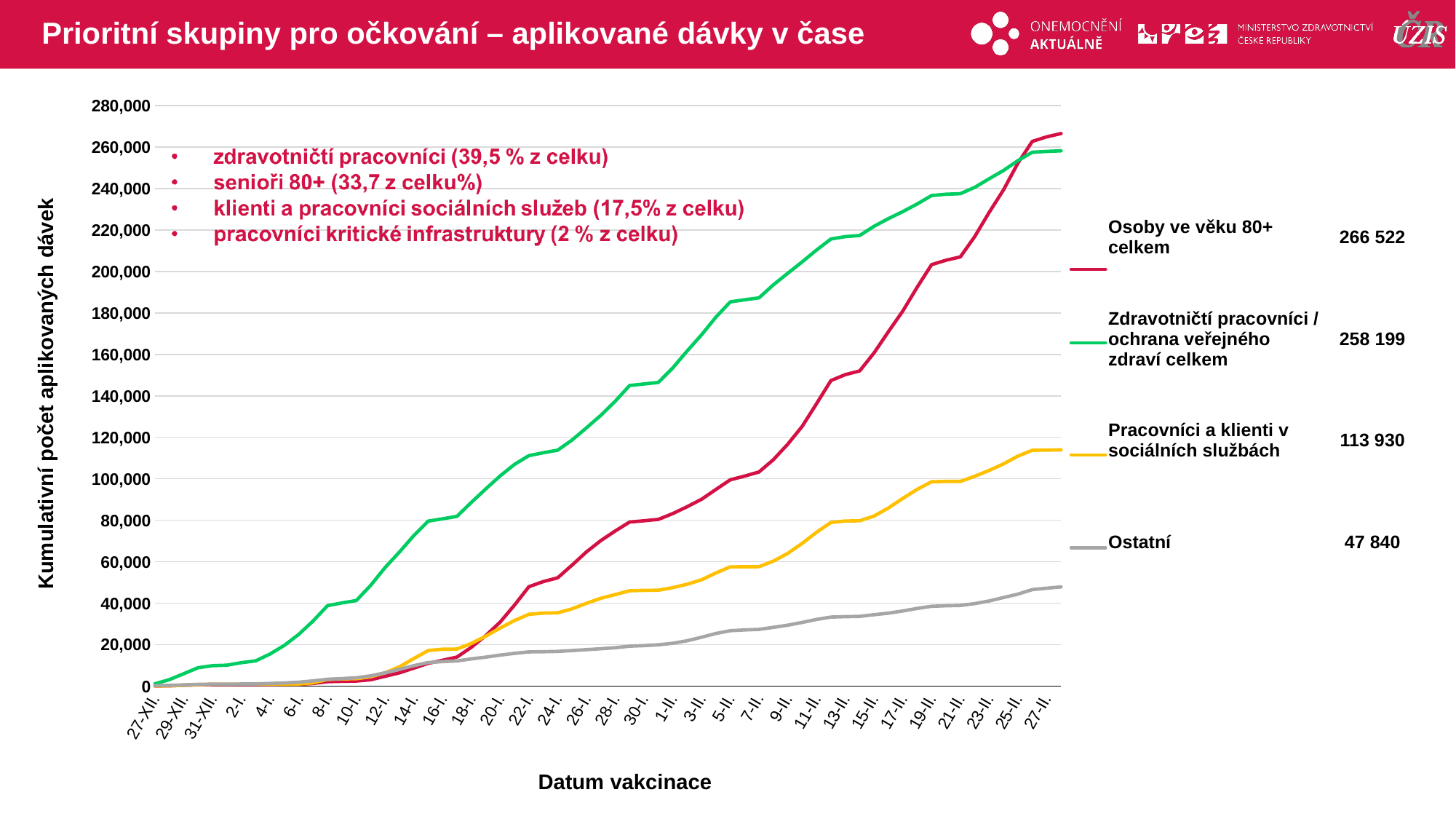
What is the final cumulative value shown for 'Osoby ve věku 80+ celkem'? 266 522 Do the values of the red line (Osoby ve věku 80+) rise or fall along the x axis? rise What is the difference between the final values of 'Osoby ve věku 80+ celkem' and 'Zdravotničtí pracovníci / ochrana veřejného zdraví celkem'? 8 323 What is the final cumulative value shown for 'Ostatní'? 47 840 Which series has the lowest final cumulative value? Ostatní What is the final cumulative value shown for 'Zdravotničtí pracovníci / ochrana veřejného zdraví celkem'? 258 199 Is the value of the green line (Zdravotničtí pracovníci) at 13-II. greater or less than 200,000? greater How many series does the legend list? 4 Which series has the highest final cumulative value? Osoby ve věku 80+ celkem What kind of chart is shown on the slide? line chart What is the label of the y axis? Kumulativní počet aplikovaných dávek What is the final cumulative value shown for 'Pracovníci a klienti v sociálních službách'? 113 930